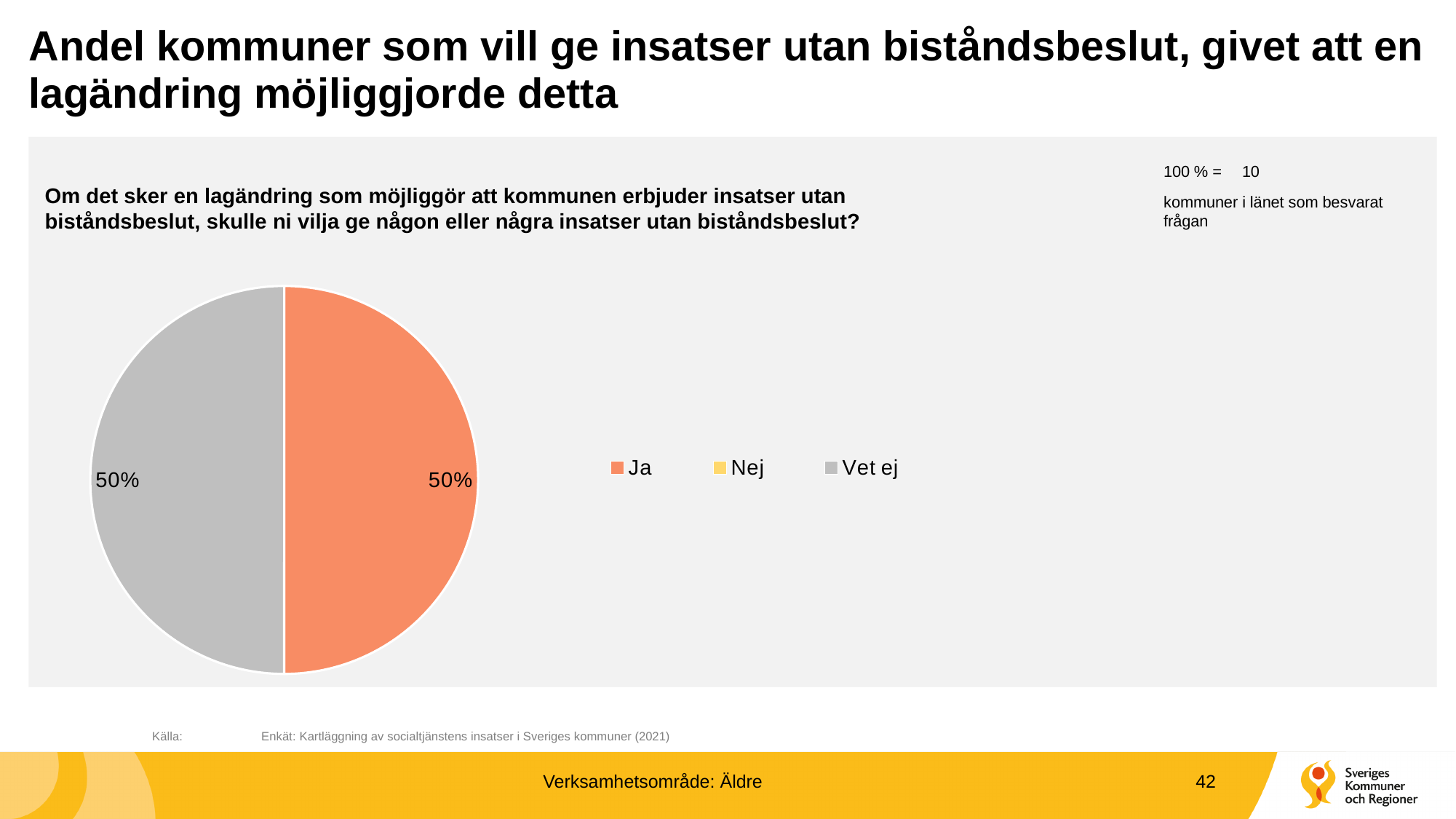
How many slices are visible in the pie chart? 2 What share of the pie does the "Vet ej" slice represent? 50% What colour is the "Ja" slice in the pie chart? orange What kind of chart is shown on the slide? pie chart Is the share for "Vet ej" greater or less than 75%? less Is the share for "Ja" greater or less than 25%? greater What share of the pie does the "Ja" slice represent? 50% How many series does the legend list? 3 Which legend entry has no visible slice in the pie chart? Nej According to the note on the slide, how many municipalities does 100 % correspond to? 10 What is the difference between the "Ja" share and the "Vet ej" share? 0% What is the combined share of the "Ja" and "Vet ej" slices? 100%